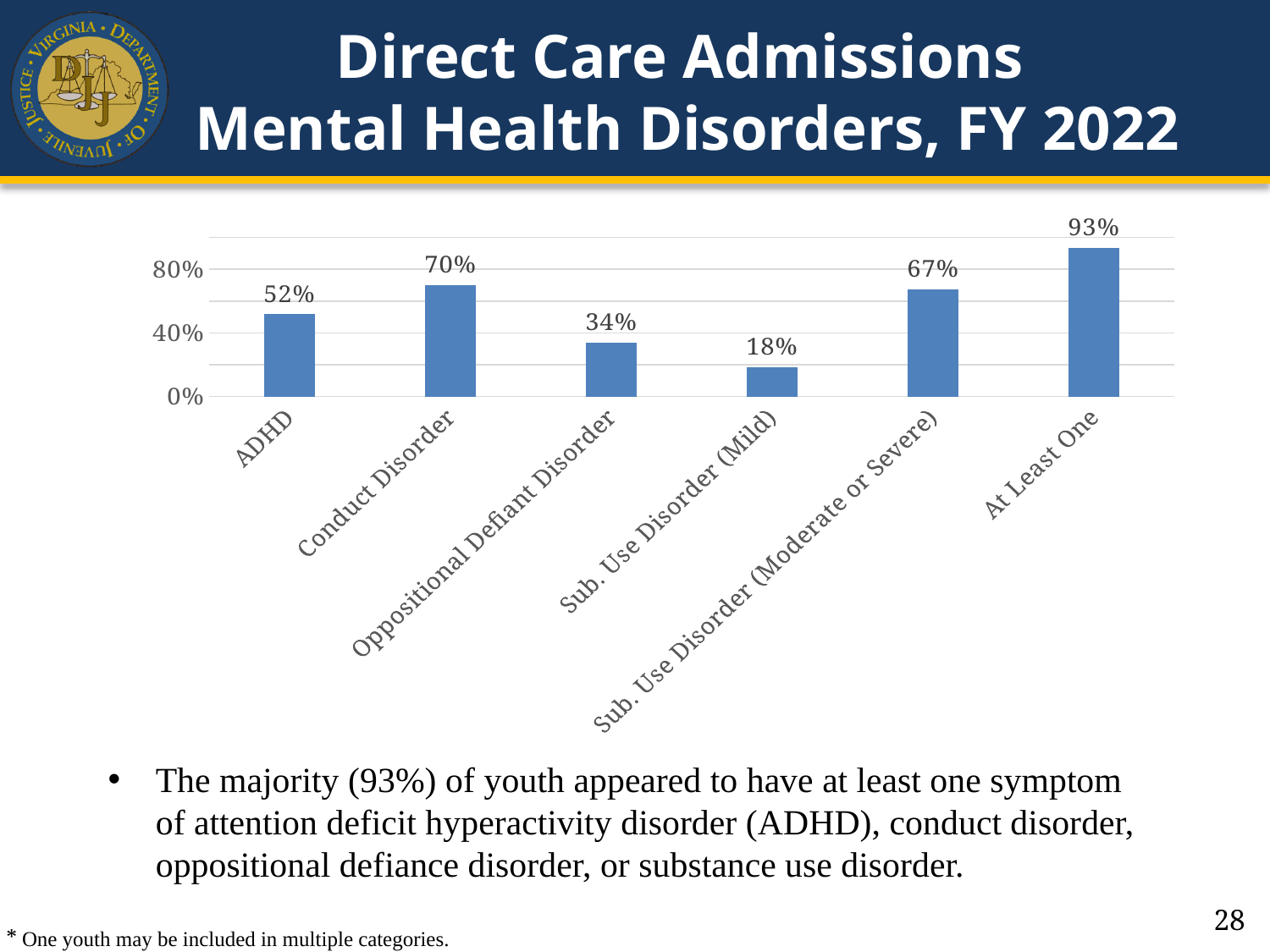
Is the value for Oppositional Defiant Disorder greater or less than 40%? less What is the title of the slide? Direct Care Admissions Mental Health Disorders, FY 2022 Which category has the lowest value? Sub. Use Disorder (Mild) What is the value for Conduct Disorder? 70% What is the value for ADHD? 52% What is the value for Sub. Use Disorder (Moderate or Severe)? 67% What kind of chart is shown on the slide? bar chart Which category has the highest value? At Least One How many categories are shown on the chart? 6 What is the difference between the values for Conduct Disorder and Oppositional Defiant Disorder? 36% What is the value for Sub. Use Disorder (Mild)? 18% Which is larger, the value for ADHD or the value for Sub. Use Disorder (Moderate or Severe)? Sub. Use Disorder (Moderate or Severe)